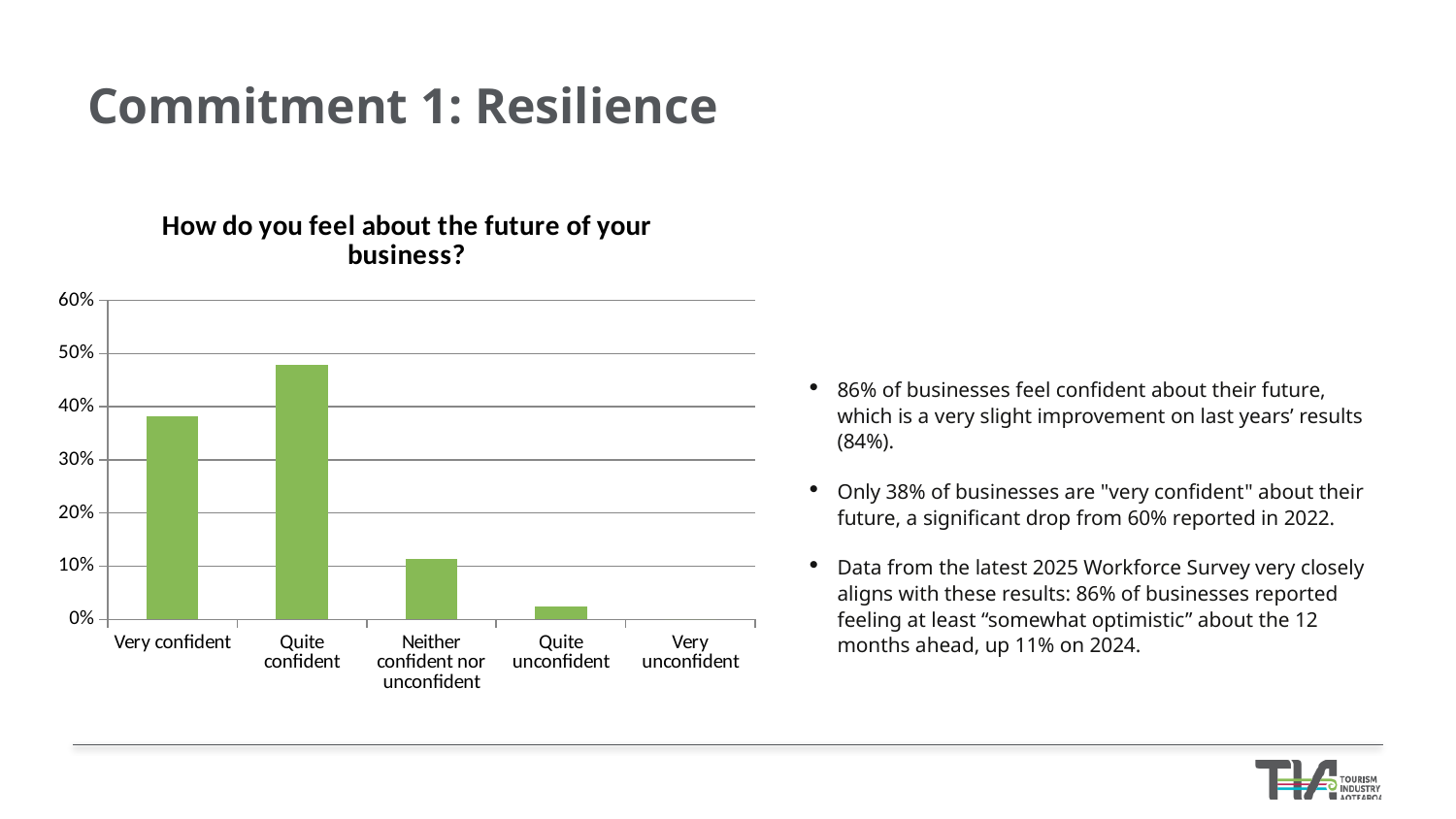
What is the title of the chart? How do you feel about the future of your business? Which category has the highest value in the chart? Quite confident How many response categories are shown on the x axis of the chart? 5 Is the value for Quite unconfident greater or less than 10%? less Is the value for Very confident greater or less than 30%? greater Which is larger, the value for Very confident or the value for Quite confident? Quite confident Is the value for Neither confident nor unconfident greater or less than 20%? less Which category has the lowest value in the chart? Very unconfident What type of chart is shown on the slide? bar chart Which is larger, the value for Neither confident nor unconfident or the value for Quite unconfident? Neither confident nor unconfident Moving from Quite confident to Very unconfident along the x axis, do the values rise or fall? fall